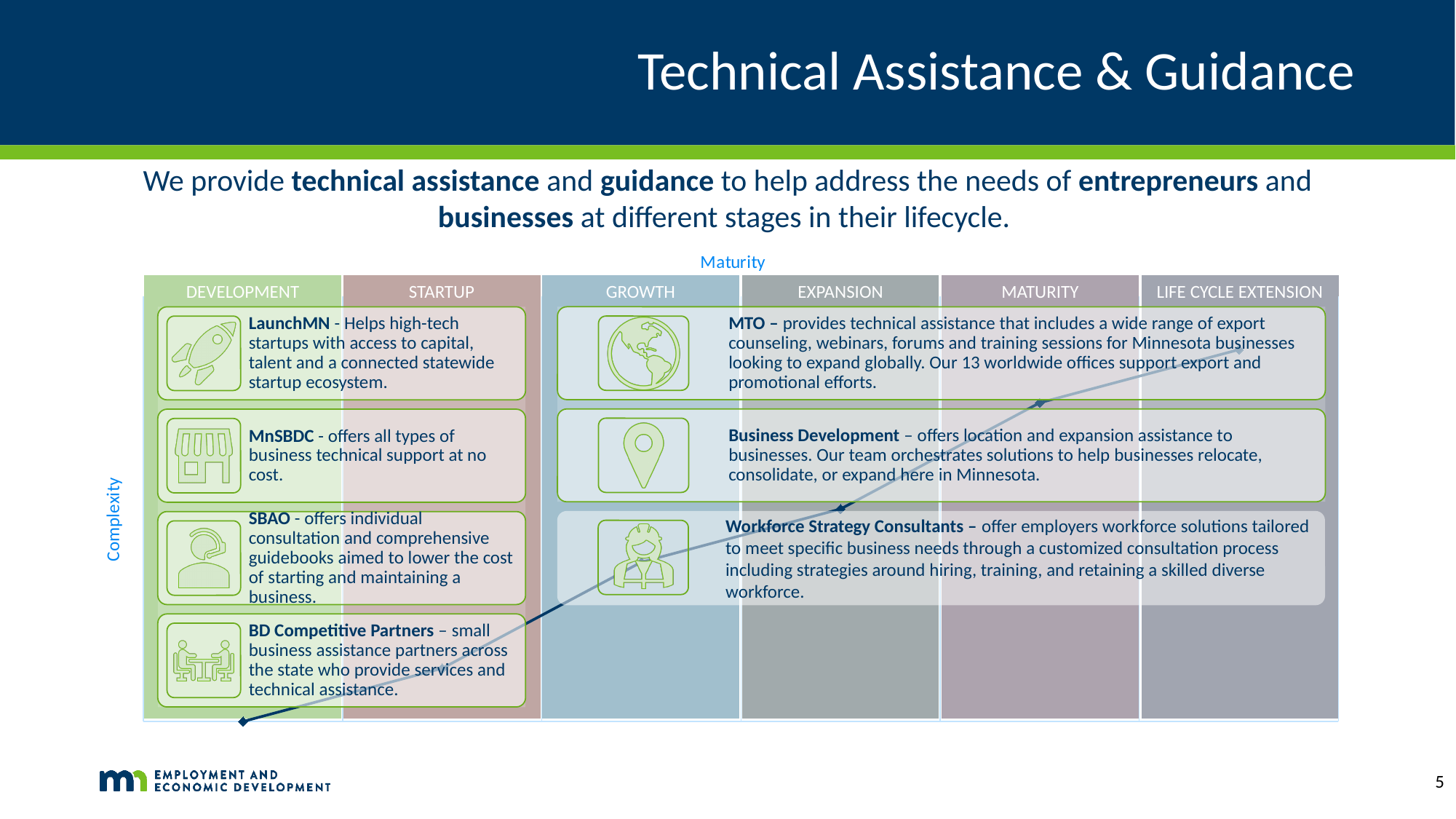
Does the plotted line rise or fall as maturity increases along the x axis? rises How many lifecycle stages are shown along the x axis of the chart? 6 What is the label on the vertical axis of the chart? Complexity In which stage does the line reach its highest point? Life Cycle Extension In which stage does the line have its lowest point? Development What kind of chart is drawn over the lifecycle stage grid on the slide? line chart Is the line higher in the Growth stage or in the Maturity stage? Maturity What is the label on the horizontal axis of the chart? Maturity